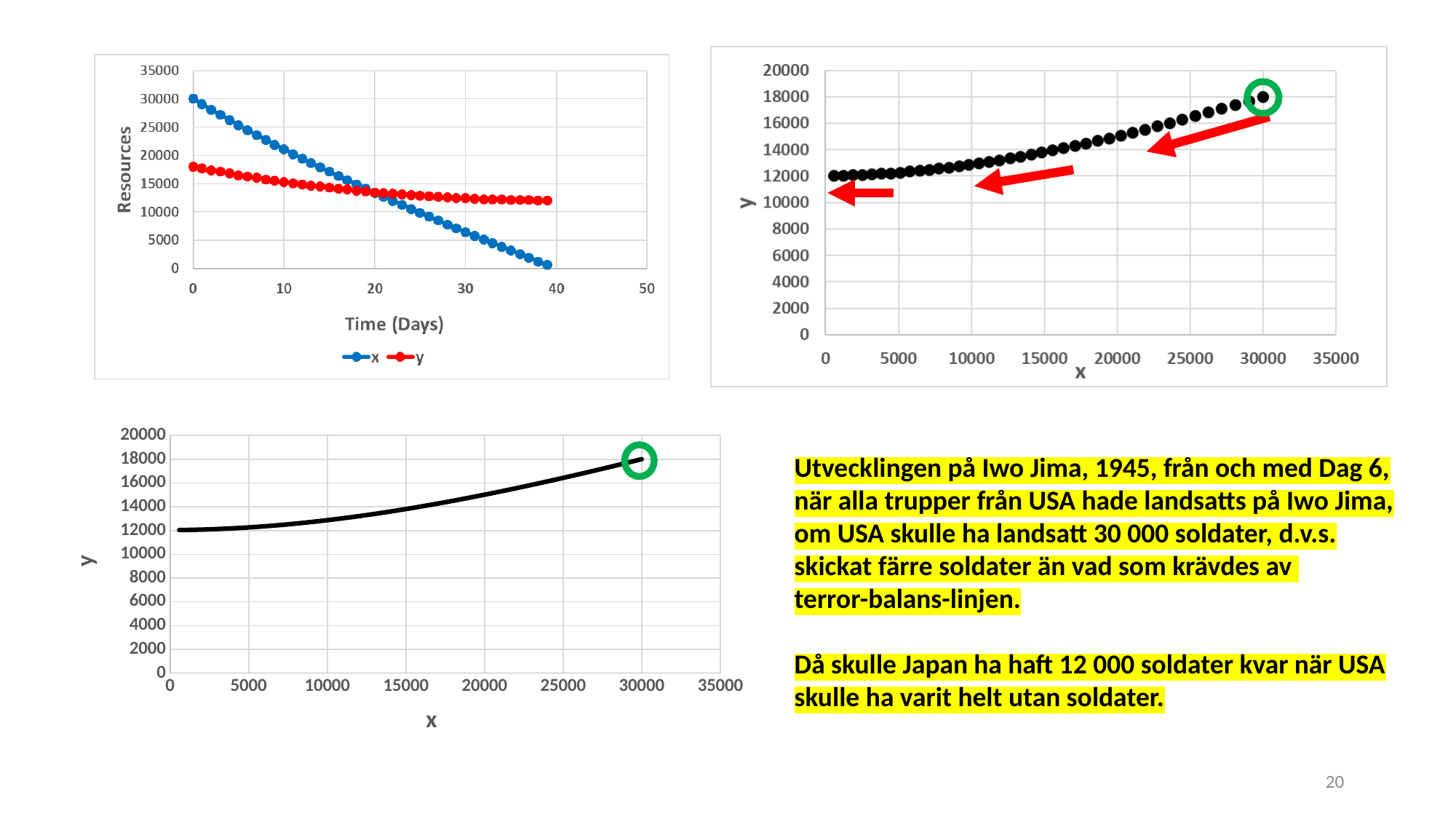
In the top-left chart, at day 30, which series has the larger value, x or y? y In the top-left chart, at day 0, which series has the larger value, x or y? x In the top-left chart, what is the title of the horizontal axis? Time (Days) In the top-left chart, what is the title of the vertical axis? Resources In the bottom-left chart, is the value of y at x = 5000 greater or less than 14000? less In the top-right chart, does y rise or fall as x increases? Rise In the top-left chart, does series x rise or fall as time increases? Fall In the top-left chart, is the value of series y at day 0 greater or less than 15000? greater In the top-right chart, is the value of y at x = 30000 greater or less than 16000? greater What kind of chart is the bottom-left chart? Line chart In the top-left chart, how many series does the legend list? 2